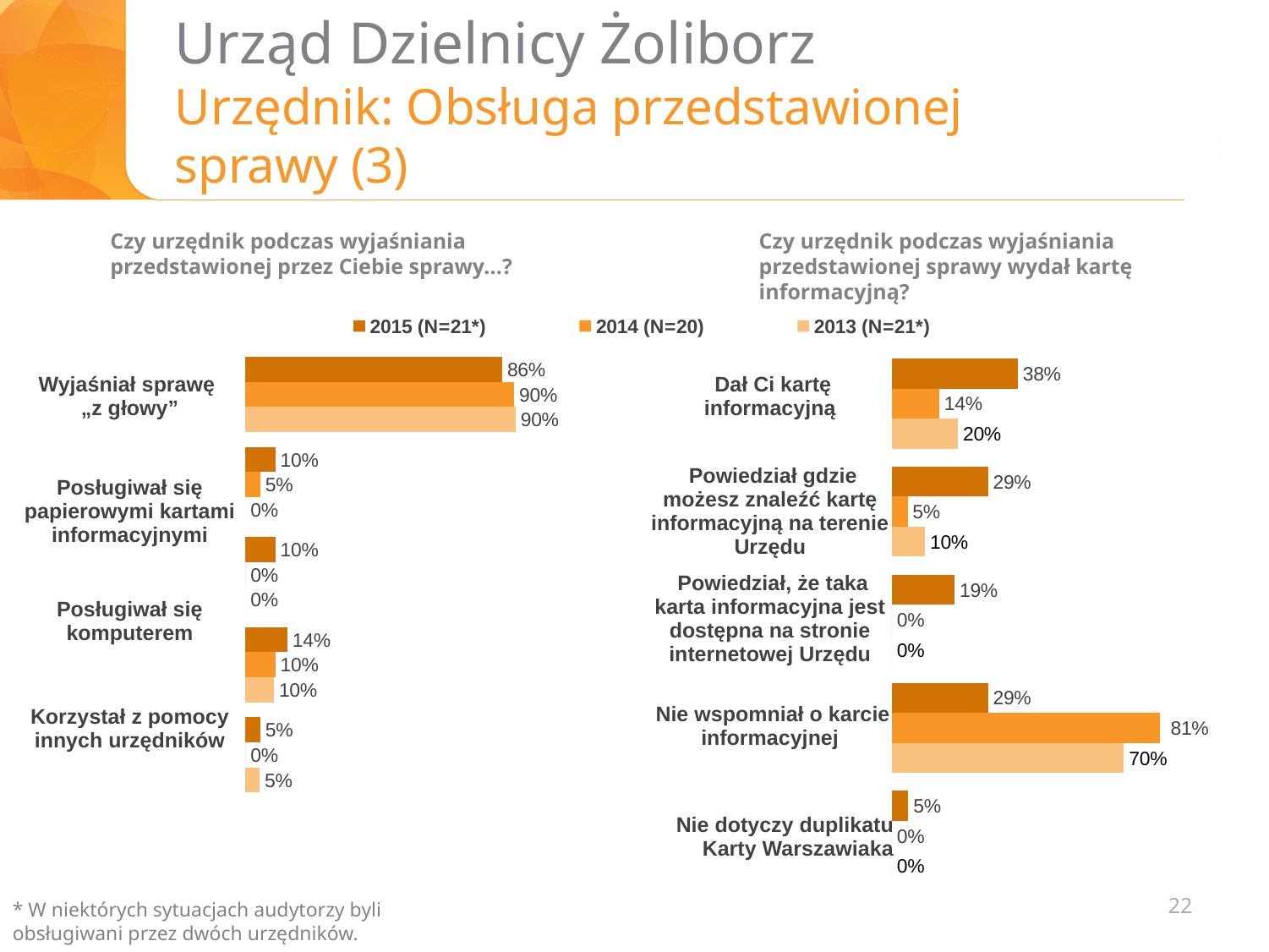
How many categories does the right chart show? 5 How many series does the legend list? 3 In the right chart, what is the difference between the 2014 and 2013 values for "Nie wspomniał o karcie informacyjnej"? 11 percentage points In the left chart, what is the difference between the 2014 and 2015 values for "Wyjaśniał sprawę „z głowy”"? 4 percentage points In the right chart ("Czy urzędnik podczas wyjaśniania przedstawionej sprawy wydał kartę informacyjną?"), what is the 2015 value for "Dał Ci kartę informacyjną"? 38% In the right chart, which category has the highest 2014 value? Nie wspomniał o karcie informacyjnej In the right chart, what is the 2014 value for "Nie wspomniał o karcie informacyjnej"? 81% In the left chart ("Czy urzędnik podczas wyjaśniania przedstawionej przez Ciebie sprawy...?"), what is the 2015 value for "Wyjaśniał sprawę „z głowy”"? 86% What type of chart is used on this slide? Bar chart In the right chart, which category has the lowest 2015 value? Nie dotyczy duplikatu Karty Warszawiaka In the right chart, what is the 2013 value for "Powiedział gdzie możesz znaleźć kartę informacyjną na terenie Urzędu"? 10% In the right chart, for "Dał Ci kartę informacyjną", which year has the larger value: 2014 or 2013? 2013